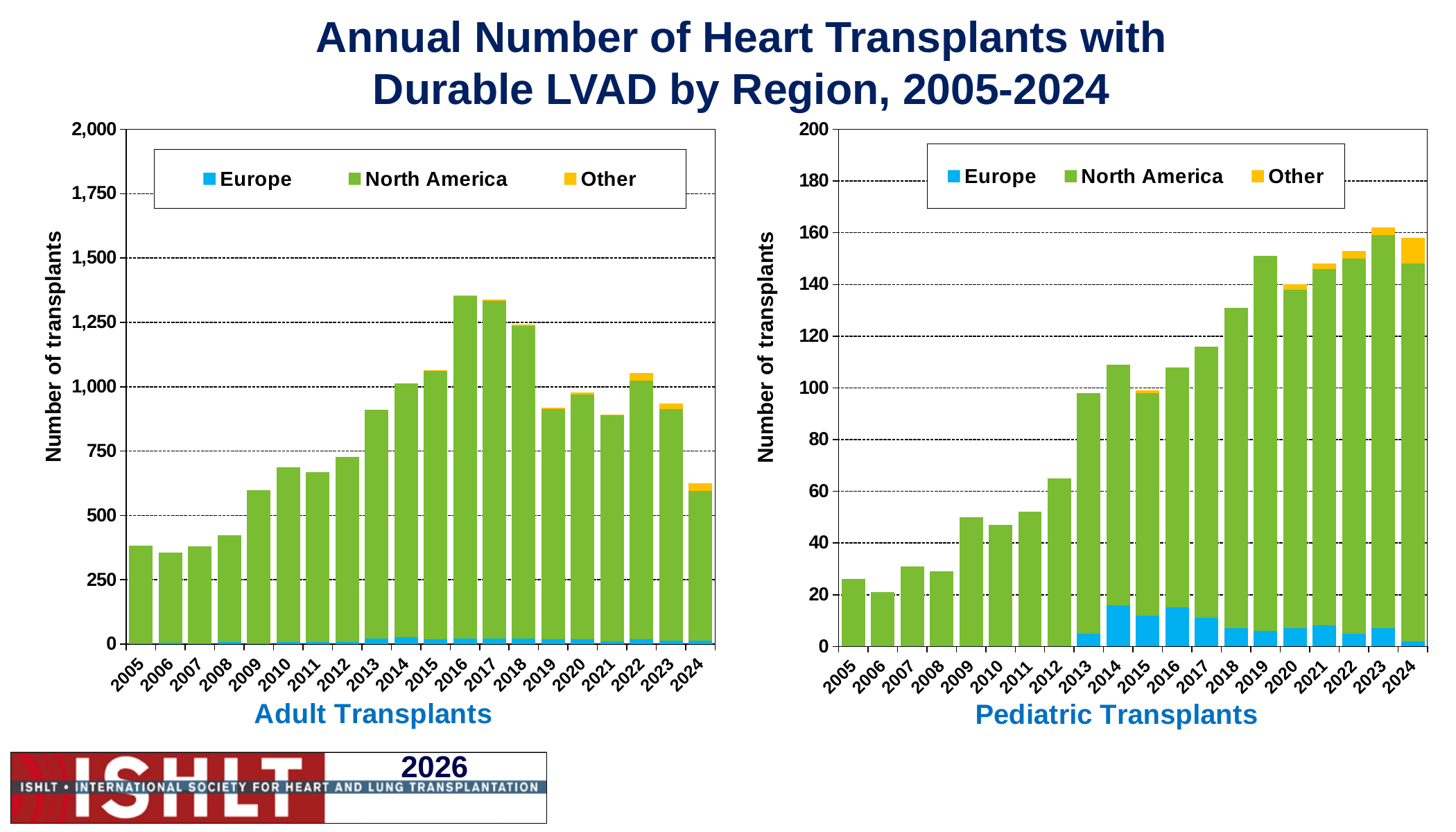
In the Pediatric Transplants chart, do the totals generally rise or fall from 2005 to 2019? rise In the Adult Transplants chart, which year has the larger total, 2018 or 2019? 2018 Which region is shown in green in the legends of both charts? North America How many years are shown on the x axis of the Adult Transplants chart? 20 In the Pediatric Transplants chart, which year has the lowest total number of transplants? 2006 In the Pediatric Transplants chart, is the total for 2012 greater or less than 80? less How many series does the legend of the Pediatric Transplants chart list? 3 In the Adult Transplants chart, is the total for 2016 greater or less than 1,250? greater In the Adult Transplants chart, is the total for 2005 greater or less than 500? less In the Adult Transplants chart, which year has the lowest total number of transplants? 2006 What type of chart is the Adult Transplants chart? Stacked bar chart